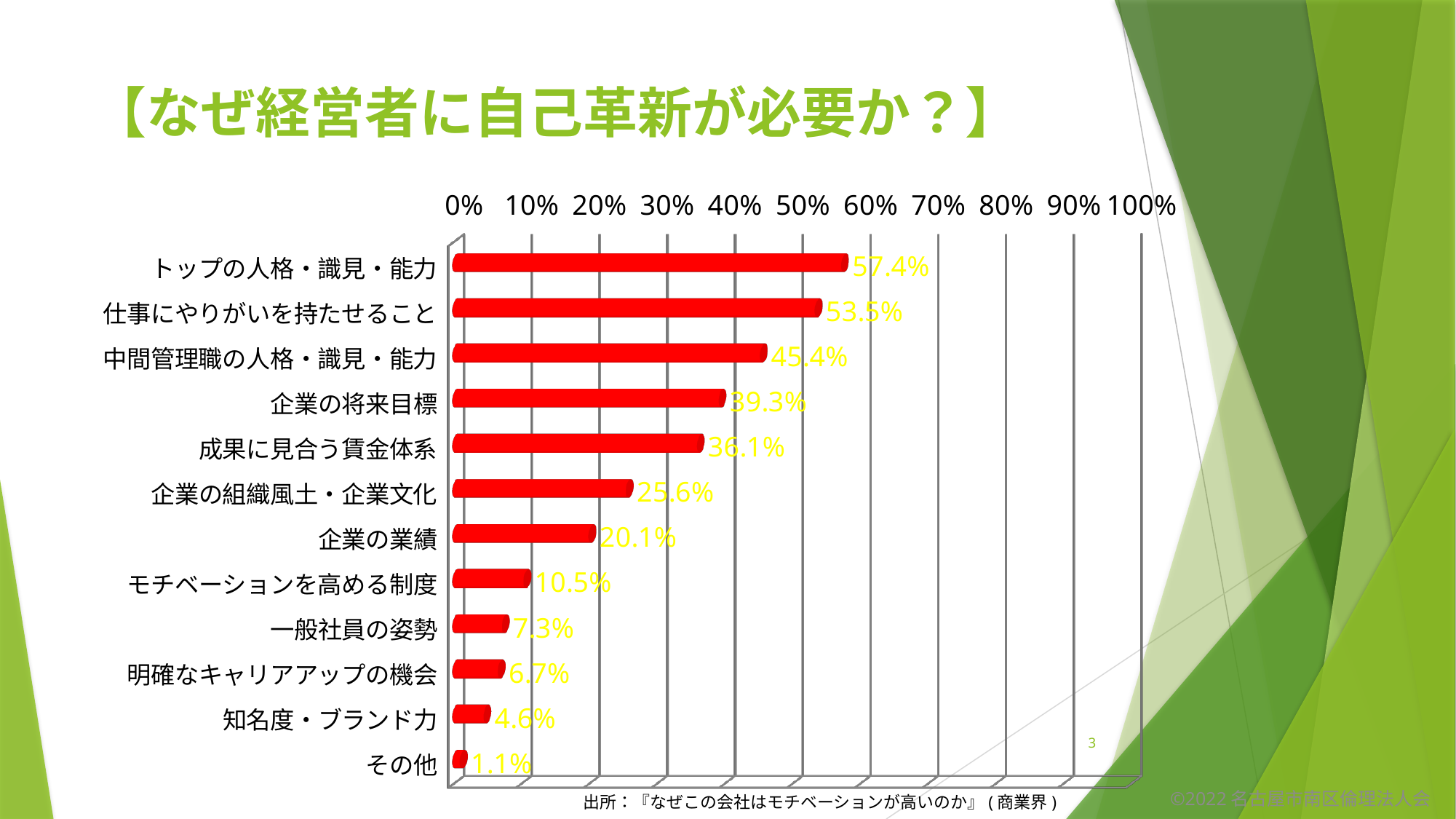
What colour are the bars in the chart? red Which category has the highest value? トップの人格・識見・能力 What is the value for 企業の業績? 20.1% What is the value for 知名度・ブランド力? 4.6% Which category has the lowest value? その他 What is the difference between モチベーションを高める制度 and 一般社員の姿勢? 3.2% What is the difference between 仕事にやりがいを持たせること and 中間管理職の人格・識見・能力? 8.1% How many categories are shown in the chart? 12 What is the value for トップの人格・識見・能力? 57.4% Is the value for 企業の組織風土・企業文化 greater or less than 30%? less What kind of chart is shown on the slide? bar chart Which is larger, 企業の将来目標 or 成果に見合う賃金体系? 企業の将来目標